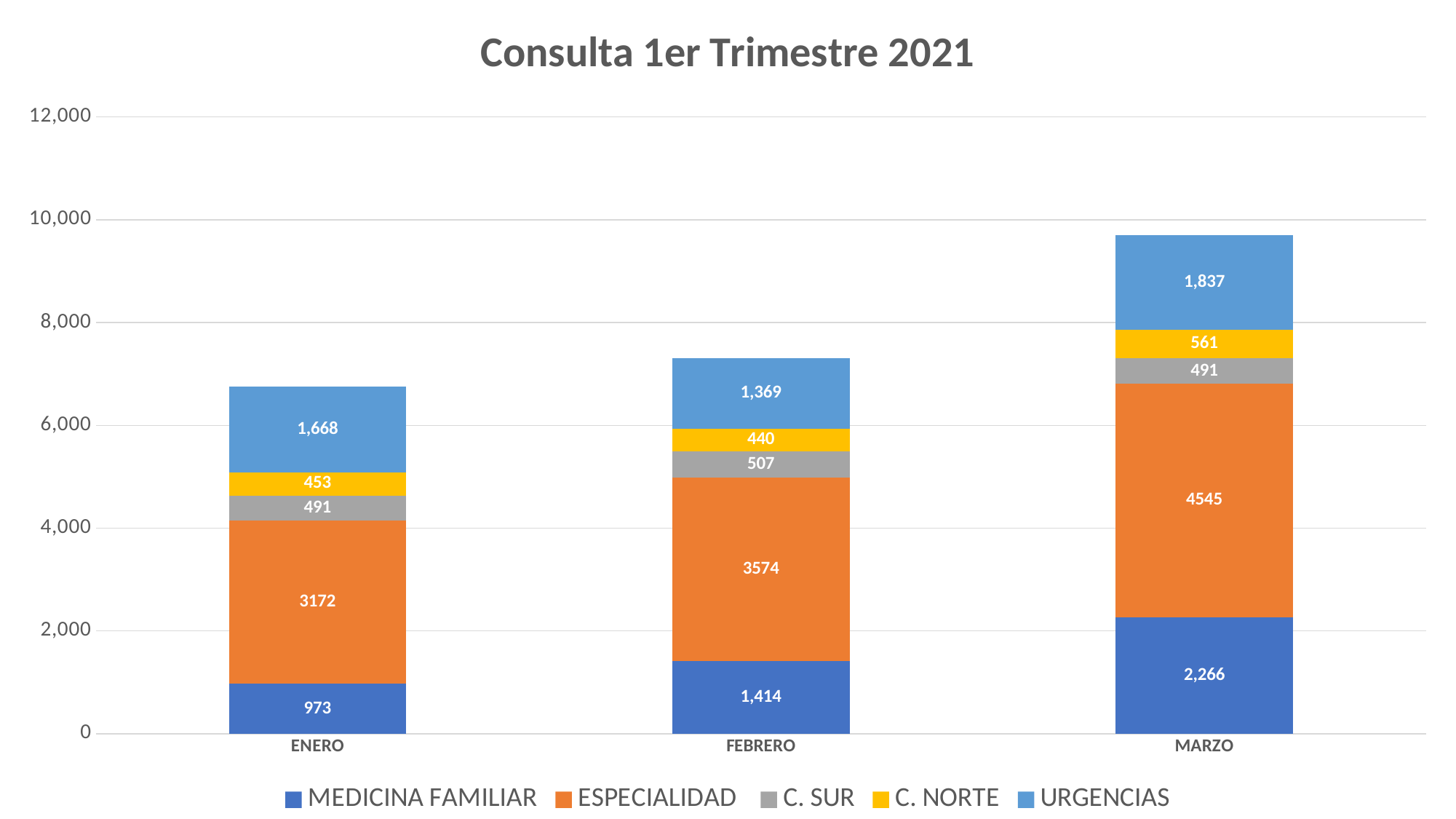
Which is larger, C. SUR in FEBRERO or C. NORTE in FEBRERO? C. SUR in FEBRERO What is the value for ESPECIALIDAD in MARZO? 4545 What is the value for URGENCIAS in ENERO? 1,668 Which month has the lowest value for URGENCIAS? FEBRERO What is the difference between the ESPECIALIDAD values for MARZO and ENERO? 1373 Does the total height of the bars rise or fall from ENERO to MARZO? rise What type of chart is shown on the slide? stacked bar chart How many series does the legend list? 5 What is the value for C. NORTE in FEBRERO? 440 What is the total of the stacked bar for MARZO? 9,700 What is the value for MEDICINA FAMILIAR in FEBRERO? 1,414 Which month has the highest value for MEDICINA FAMILIAR? MARZO